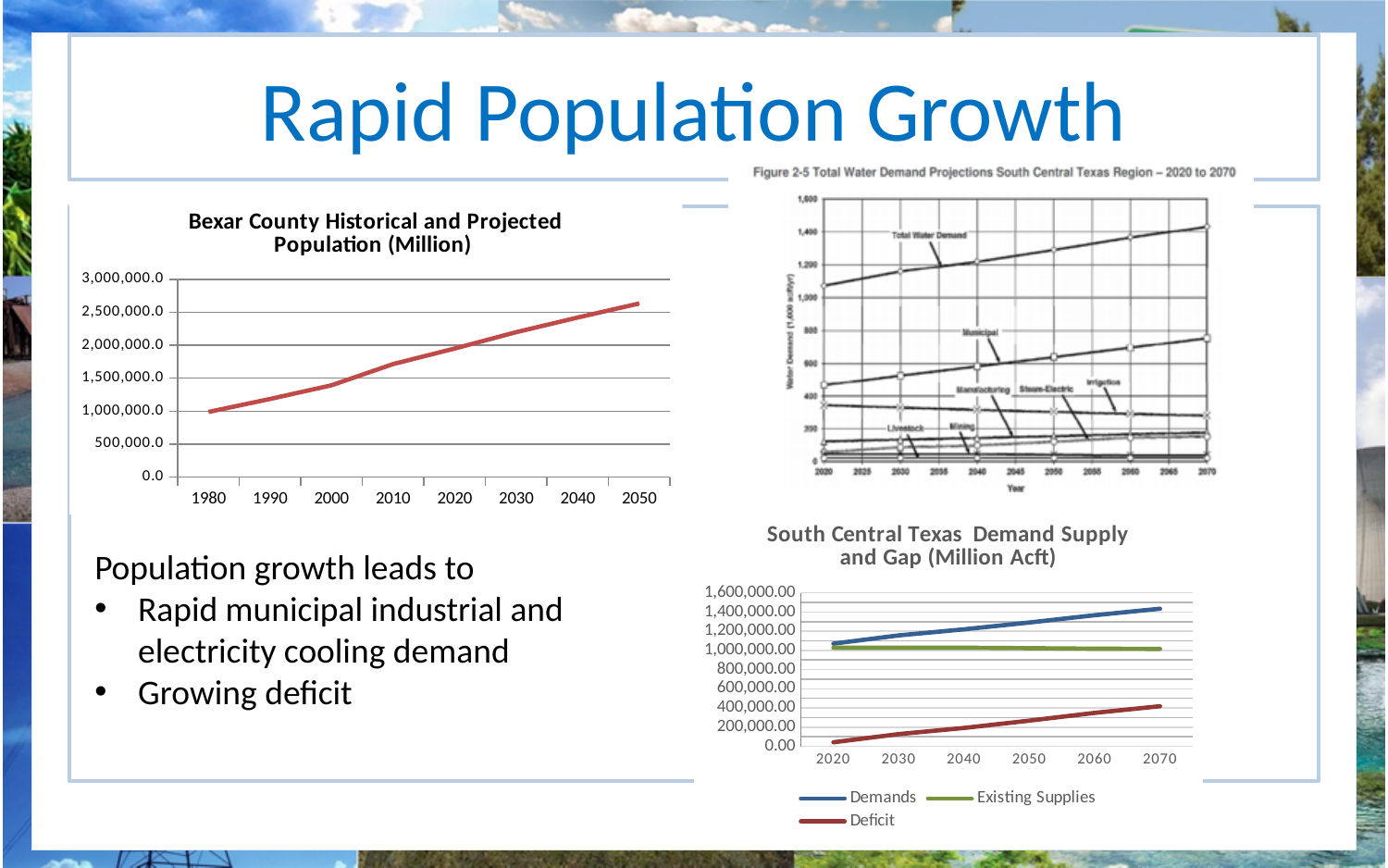
In the 'South Central Texas Demand Supply and Gap (Million Acft)' chart, which series is higher in 2070, Demands or Existing Supplies? Demands In the 'Bexar County Historical and Projected Population (Million)' chart, does the population rise or fall from 1980 to 2050? rise In the 'South Central Texas Demand Supply and Gap (Million Acft)' chart, is the Demands value for 2070 greater or less than 1,200,000.00? greater In the 'South Central Texas Demand Supply and Gap (Million Acft)' chart, does the Deficit series rise or fall from 2020 to 2070? rise How many years are labelled on the x axis of the 'Bexar County Historical and Projected Population (Million)' chart? 8 In the 'South Central Texas Demand Supply and Gap (Million Acft)' chart, which series is shown in red? Deficit How many series does the legend of the 'South Central Texas Demand Supply and Gap (Million Acft)' chart list? 3 In the 'Bexar County Historical and Projected Population (Million)' chart, is the value for 2000 greater or less than 1,500,000.0? less In the 'South Central Texas Demand Supply and Gap (Million Acft)' chart, is the Deficit value for 2070 greater or less than 600,000.00? less What type of chart is the 'Bexar County Historical and Projected Population (Million)' chart? line chart In the 'Figure 2-5 Total Water Demand Projections South Central Texas Region – 2020 to 2070' chart, which series has the highest values? Total Water Demand